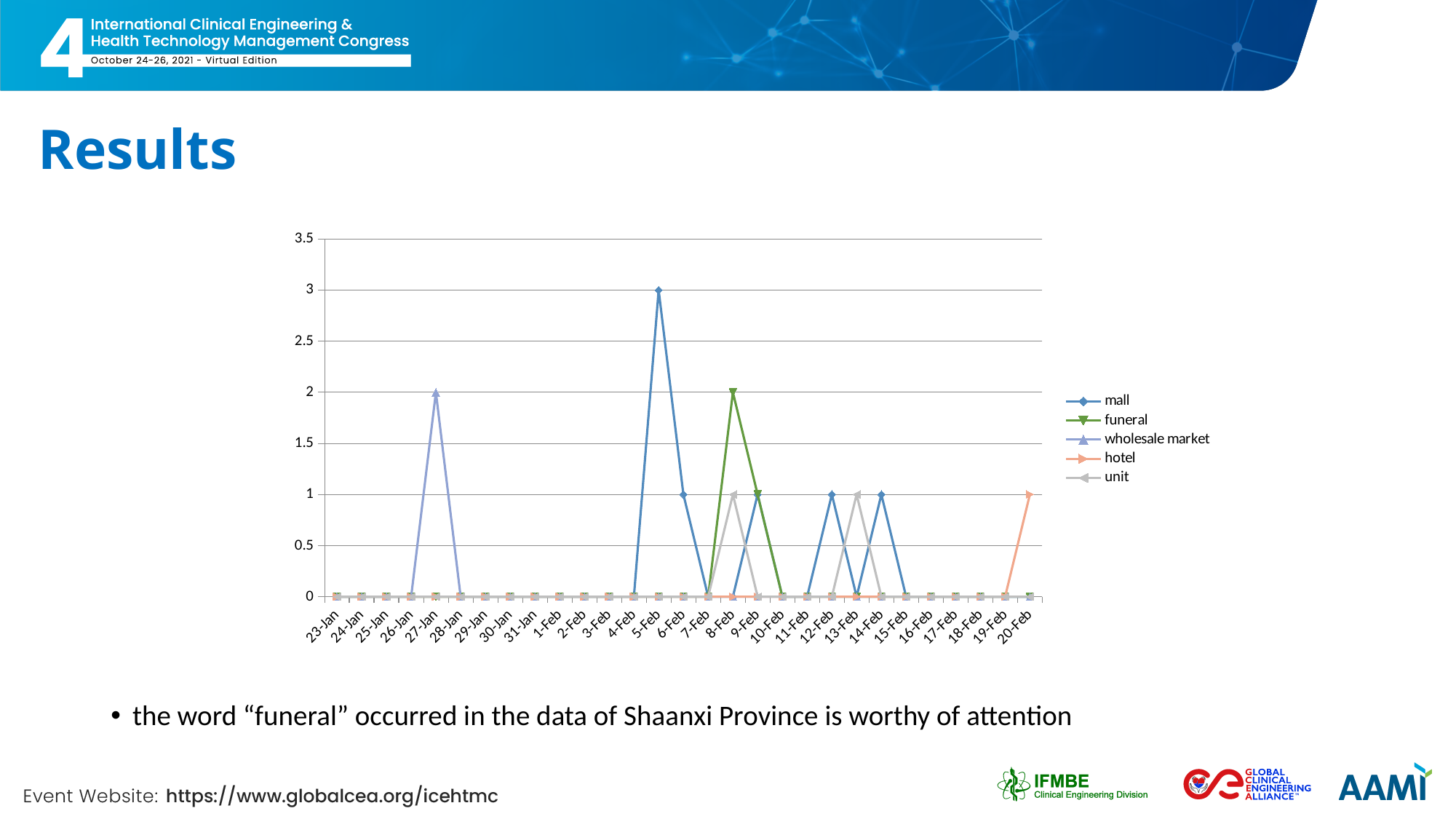
What is the value of the funeral series on 8-Feb? 2 What is the difference between the mall value on 5-Feb and the funeral value on 8-Feb? 1 What is the value of the hotel series on 20-Feb? 1 What is the value of the mall series on 5-Feb? 3 What is the value of the wholesale market series on 27-Jan? 2 Which is larger: the wholesale market value on 27-Jan or the unit value on 13-Feb? wholesale market on 27-Jan How many dates are shown along the x axis? 29 On which date does the mall series reach its highest value? 5-Feb What kind of chart is shown on the slide? line chart Which series reaches the highest value on the chart? mall Which series is drawn in green in the legend? funeral How many series does the legend list? 5